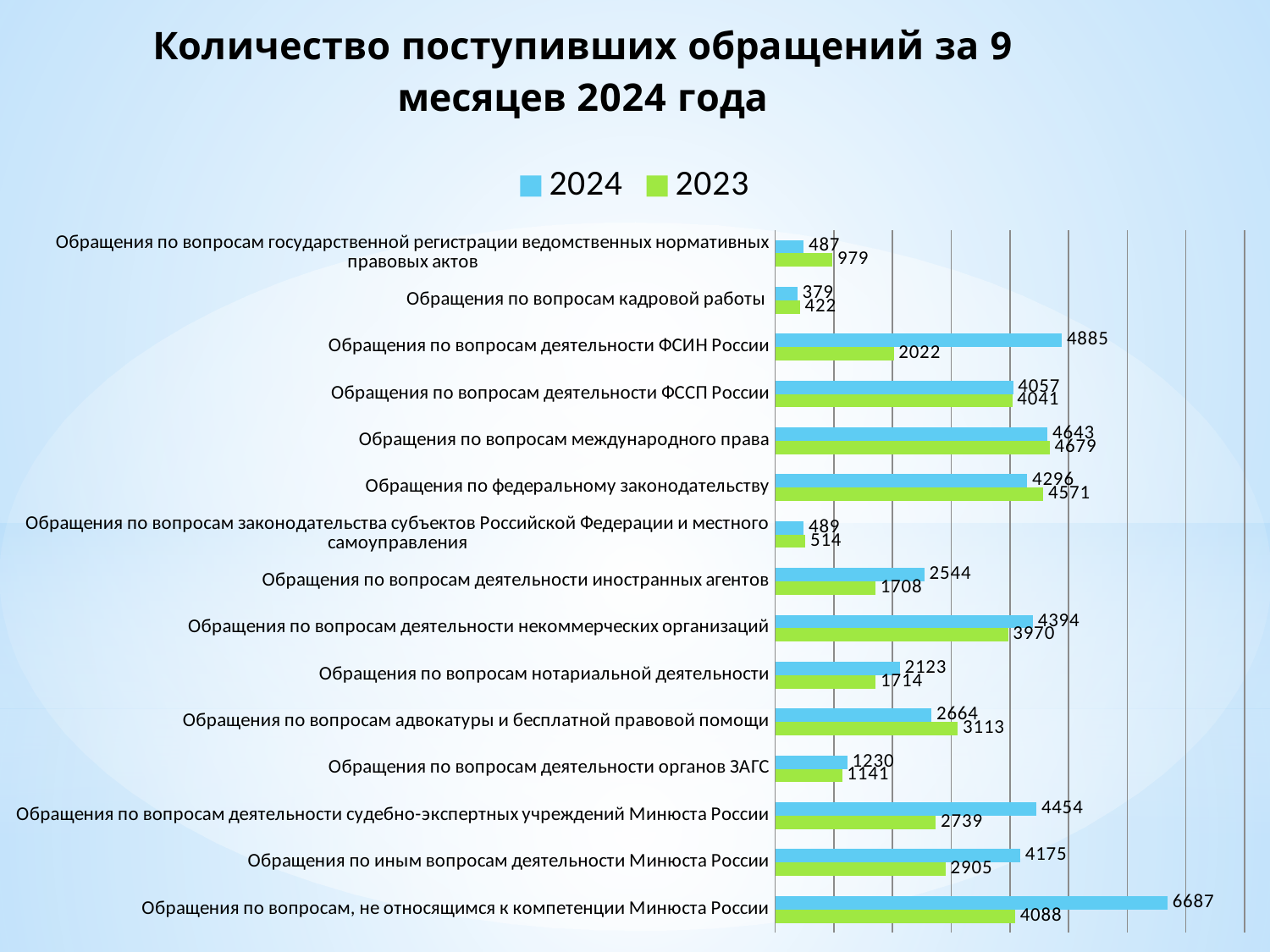
What is the difference between the 2024 and 2023 values for "Обращения по вопросам, не относящимся к компетенции Минюста России"? 2599 What is the difference between the 2024 and 2023 values for "Обращения по вопросам деятельности судебно-экспертных учреждений Минюста России"? 1715 What is the 2024 value for "Обращения по вопросам деятельности ФСИН России"? 4885 How many categories are shown in the chart? 15 What is the 2023 value for "Обращения по вопросам государственной регистрации ведомственных нормативных правовых актов"? 979 For "Обращения по вопросам адвокатуры и бесплатной правовой помощи", which year has the larger value, 2024 or 2023? 2023 What type of chart is shown on the slide? bar chart Which category has the highest 2024 value? Обращения по вопросам, не относящимся к компетенции Минюста России Which category has the lowest 2024 value? Обращения по вопросам кадровой работы Which colour represents the 2023 series in the legend? green What is the 2023 value for "Обращения по вопросам деятельности иностранных агентов"? 1708 How many series does the legend list? 2